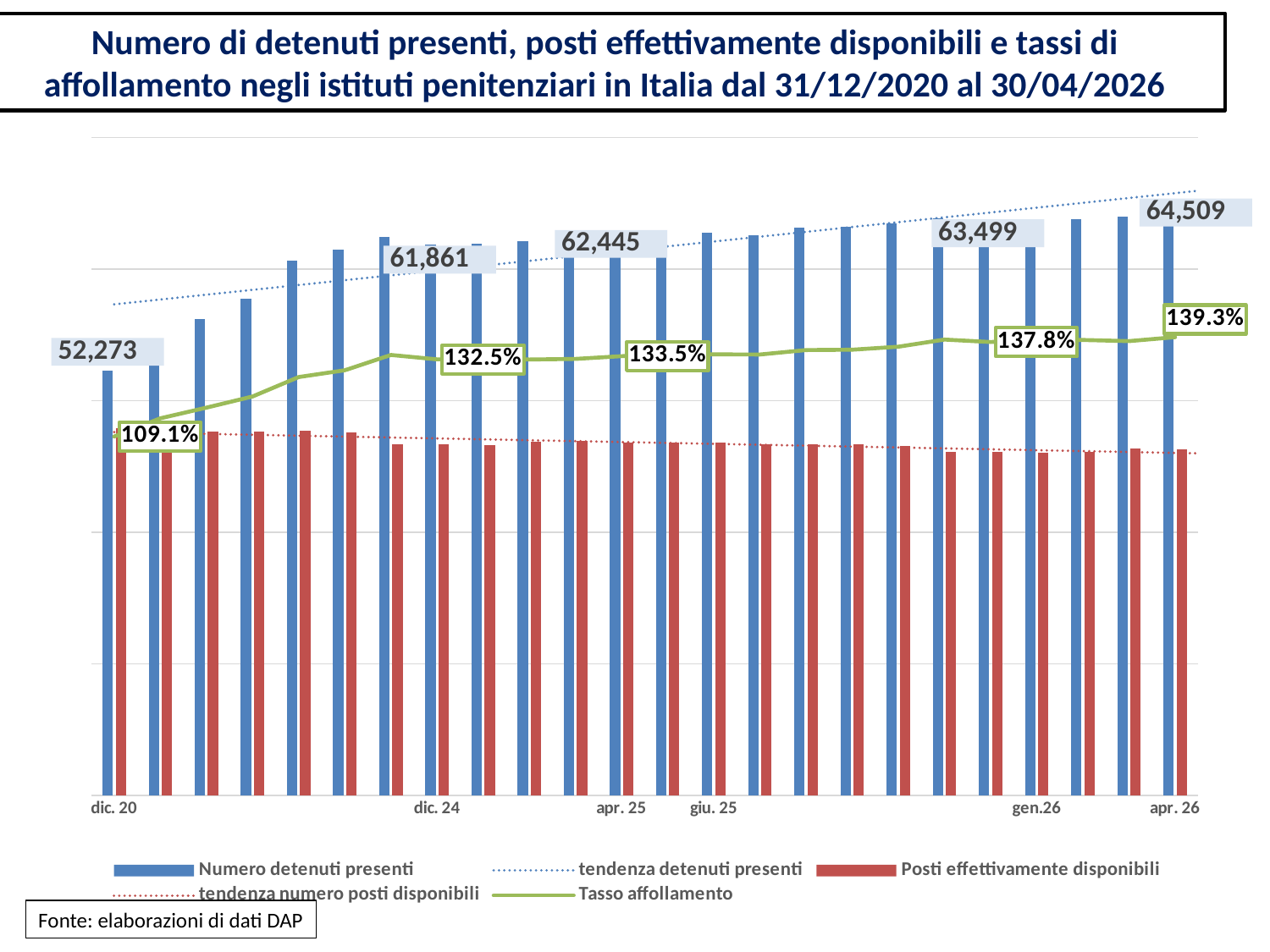
What kind of chart is shown on the slide? Bar chart combined with line series What is the value of Numero detenuti presenti at apr. 26? 64,509 What is the Tasso affollamento at apr. 25? 133.5% What is the Tasso affollamento at dic. 20? 109.1% What is the value of Numero detenuti presenti at dic. 24? 61,861 By how much did Numero detenuti presenti increase from dic. 20 to apr. 26? 12,236 What is the Tasso affollamento at apr. 26? 139.3% At which date is the Tasso affollamento lowest? dic. 20 How many series does the legend list? 5 At apr. 26, which is larger: Numero detenuti presenti or Posti effettivamente disponibili? Numero detenuti presenti What is the value of Numero detenuti presenti at dic. 20? 52,273 Does Numero detenuti presenti rise or fall from dic. 20 to apr. 26? Rise